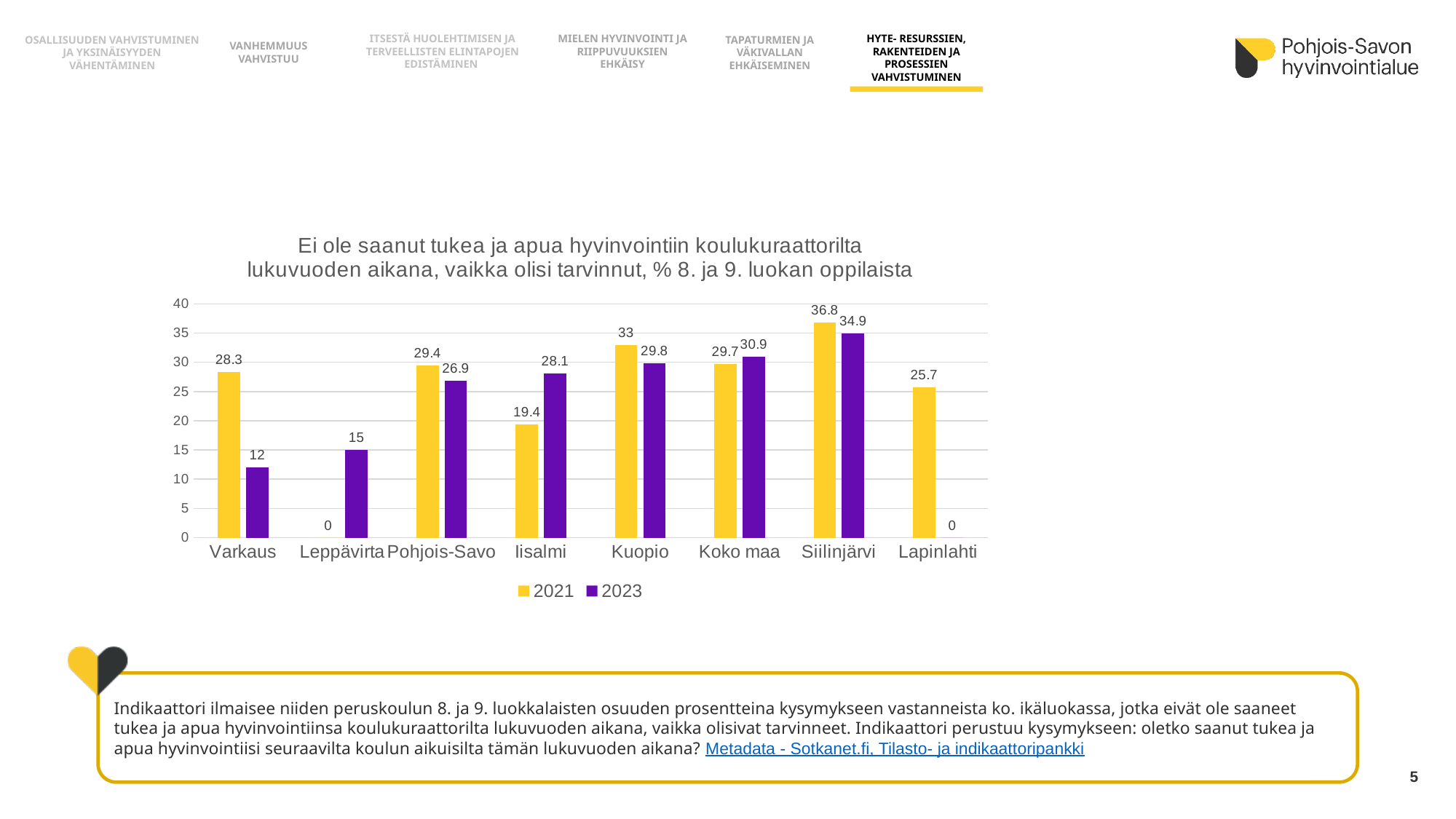
What is the 2023 value for Koko maa? 30.9 What is the 2023 value for Iisalmi? 28.1 How many series does the legend list? 2 How many categories are shown on the x axis? 8 Which colour represents the 2023 series in the legend? Purple Which category has the lowest 2023 value? Lapinlahti What kind of chart is shown on the slide? Bar chart Which category has the highest 2021 value? Siilinjärvi What is the 2021 value for Varkaus? 28.3 What is the difference between the 2021 and 2023 values for Varkaus? 16.3 Is the 2023 value for Siilinjärvi greater or less than 30? greater Which is larger for Kuopio, the 2021 value or the 2023 value? 2021